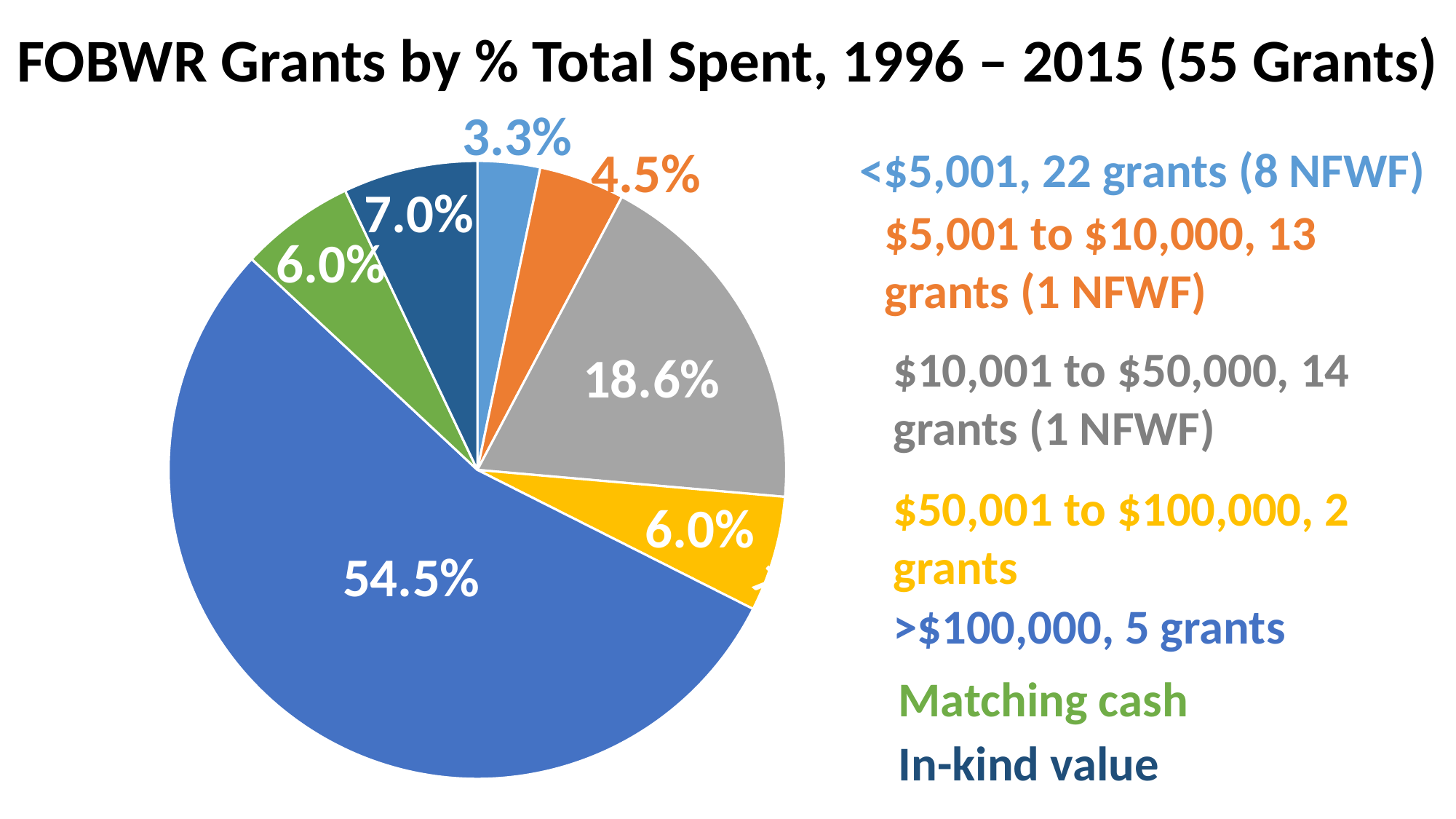
What is the difference in percentage points between the >$100,000 slice and the $10,001 to $50,000 slice? 35.9 Which category has the smallest share of the pie? <$5,001, 22 grants (8 NFWF) Which is larger, the In-kind value slice or the Matching cash slice? In-kind value What percentage is shown for the In-kind value slice? 7.0% What percentage is shown for the $5,001 to $10,000 grants slice? 4.5% What percentage of total spent is shown for the $10,001 to $50,000 grants slice? 18.6% What percentage of total spent is shown for the >$100,000 grants slice? 54.5% Which category has the largest share of the pie? >$100,000, 5 grants What is the title of the chart? FOBWR Grants by % Total Spent, 1996 – 2015 (55 Grants) What percentage is shown for the <$5,001 grants slice? 3.3% What kind of chart is shown on the slide? pie chart How many slices does the pie chart have? 7